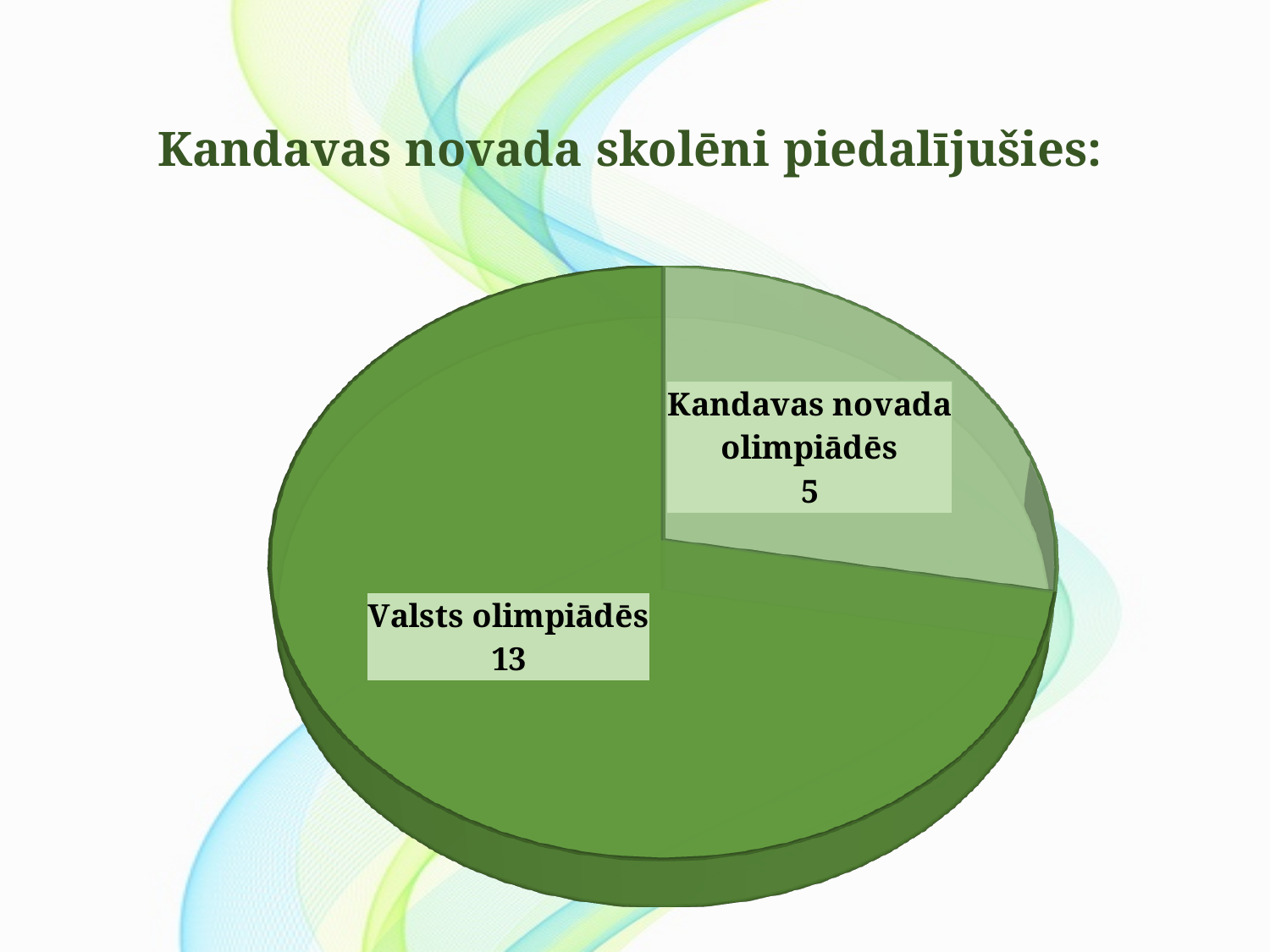
How many slices does the pie chart have? 2 Which is larger, Valsts olimpiādēs or Kandavas novada olimpiādēs? Valsts olimpiādēs What is the value for Valsts olimpiādēs? 13 Which slice is the smallest? Kandavas novada olimpiādēs What is the total of all slices in the pie chart? 18 What is the title of the slide containing the chart? Kandavas novada skolēni piedalījušies: What kind of chart is shown on the slide? pie chart Which slice is shown in the lighter green colour? Kandavas novada olimpiādēs What is the value for Kandavas novada olimpiādēs? 5 What is the difference between the values for Valsts olimpiādēs and Kandavas novada olimpiādēs? 8 Which slice is the largest? Valsts olimpiādēs